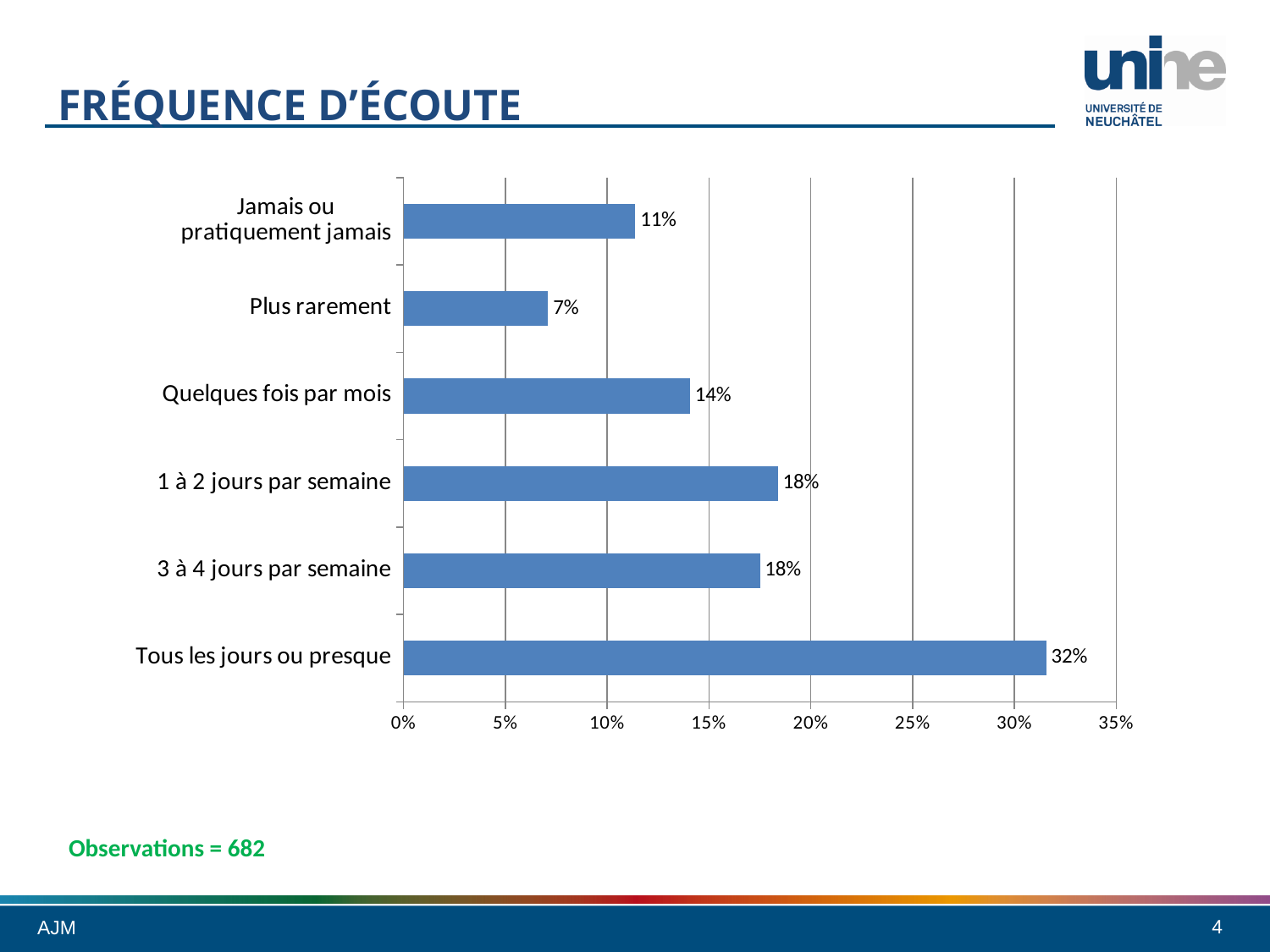
What is the value for "Plus rarement"? 7% Which is larger, the value for "Jamais ou pratiquement jamais" or the value for "Quelques fois par mois"? Quelques fois par mois How many categories are shown in the chart? 6 What is the title of the slide containing the chart? FRÉQUENCE D'ÉCOUTE What is the value for "Jamais ou pratiquement jamais"? 11% What is the difference between the values for "Tous les jours ou presque" and "Quelques fois par mois"? 18% Is the value for "Tous les jours ou presque" greater or less than 30%? greater What is the value for "Quelques fois par mois"? 14% What kind of chart is shown on the slide? bar chart Which category has the highest value? Tous les jours ou presque What is the value for "Tous les jours ou presque"? 32% Which category has the lowest value? Plus rarement